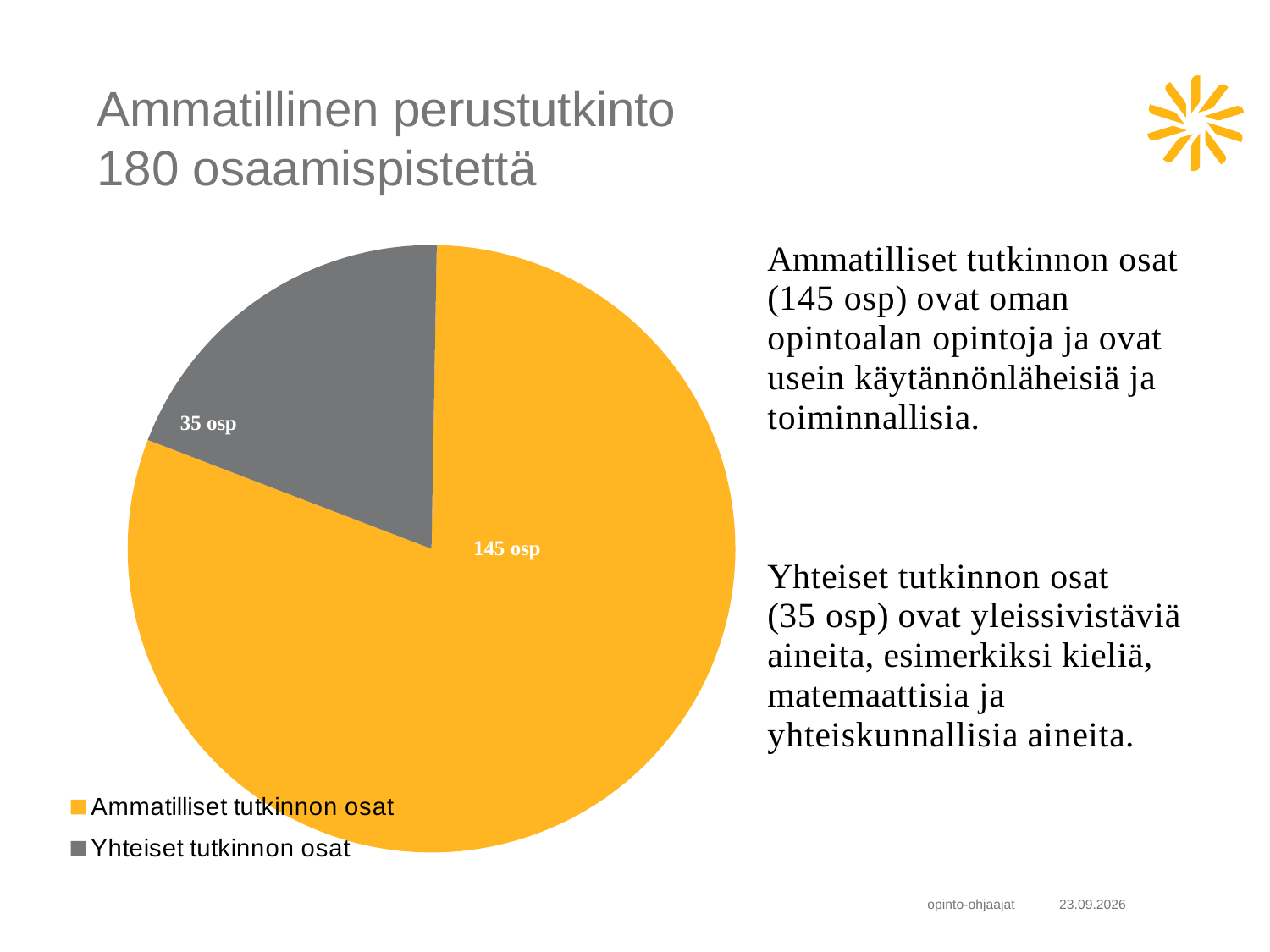
Which colour represents Yhteiset tutkinnon osat in the pie chart? grey How many entries does the legend of the pie chart list? 2 Which slice of the pie chart is the largest? Ammatilliset tutkinnon osat Which slice of the pie chart is the smallest? Yhteiset tutkinnon osat What is the difference in osp between Ammatilliset tutkinnon osat and Yhteiset tutkinnon osat? 110 osp Which is larger, Ammatilliset tutkinnon osat or Yhteiset tutkinnon osat? Ammatilliset tutkinnon osat What value is shown for Ammatilliset tutkinnon osat in the pie chart? 145 osp What value is shown for Yhteiset tutkinnon osat in the pie chart? 35 osp How many slices does the pie chart have? 2 What kind of chart is shown on the slide? pie chart Which colour represents Ammatilliset tutkinnon osat in the pie chart? orange What is the total of the two slices in the pie chart? 180 osp